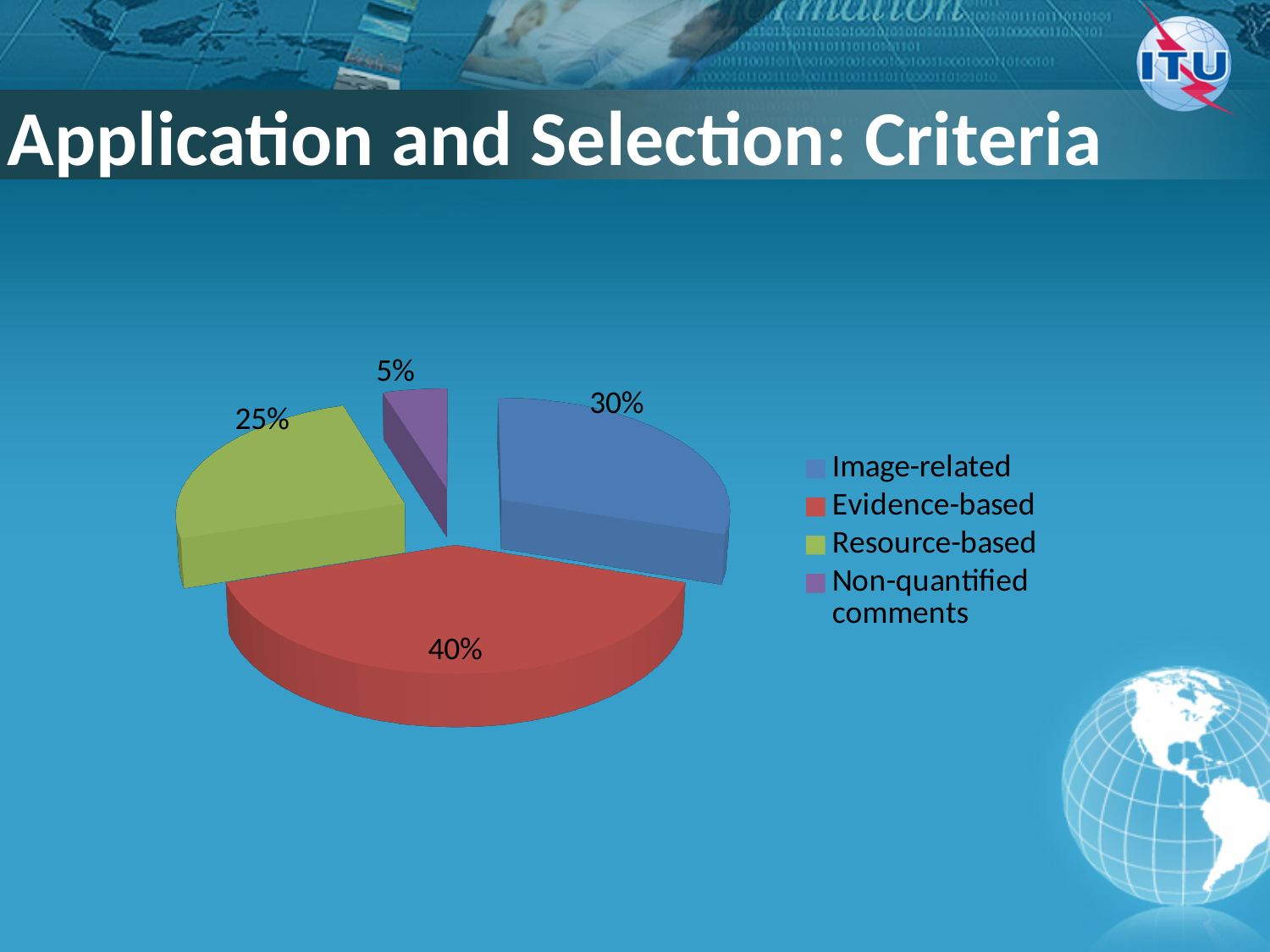
Which category has the largest slice of the pie? Evidence-based What share of the pie is Resource-based? 25% What is the difference between the Evidence-based and Image-related shares? 10% What is the difference between the Resource-based and Non-quantified comments shares? 20% What kind of chart is shown on the slide? pie chart What share of the pie is Non-quantified comments? 5% How many categories does the pie chart have? 4 Which category has the smallest slice of the pie? Non-quantified comments What share of the pie is Evidence-based? 40% What colour is the Resource-based slice? green Which is larger, the Image-related share or the Resource-based share? Image-related